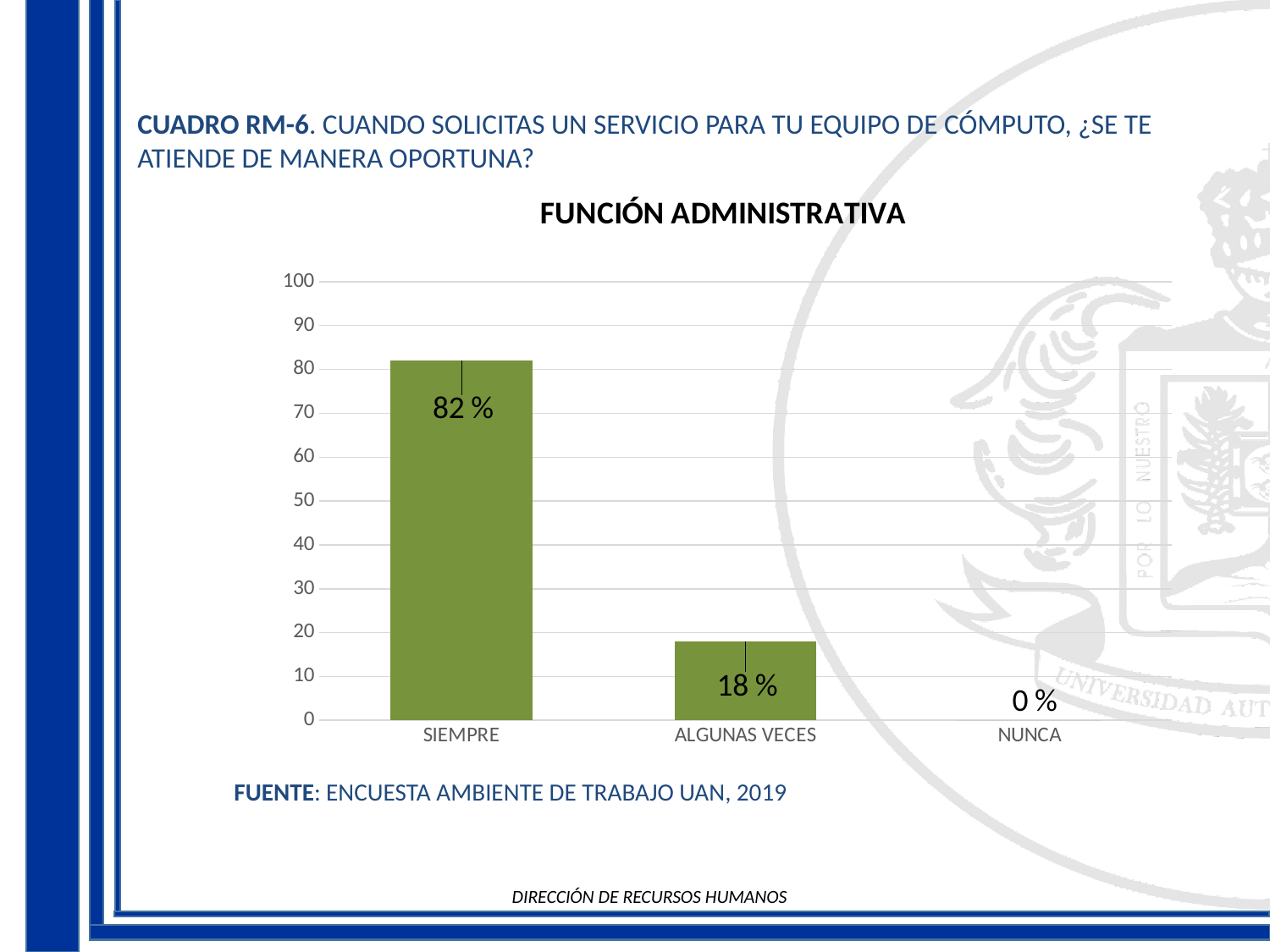
What is the value for SIEMPRE? 82 % What is the difference between the values for SIEMPRE and ALGUNAS VECES? 64 % Which category has the highest value? SIEMPRE Which category has the lowest value? NUNCA Is the value for ALGUNAS VECES greater or less than 30? less Is the value for SIEMPRE greater or less than 50? greater Which is larger, the value for SIEMPRE or the value for ALGUNAS VECES? SIEMPRE What is the title of the chart? FUNCIÓN ADMINISTRATIVA What kind of chart is shown on the slide? bar chart What is the value for ALGUNAS VECES? 18 % What is the value for NUNCA? 0 % How many categories are shown on the x axis? 3